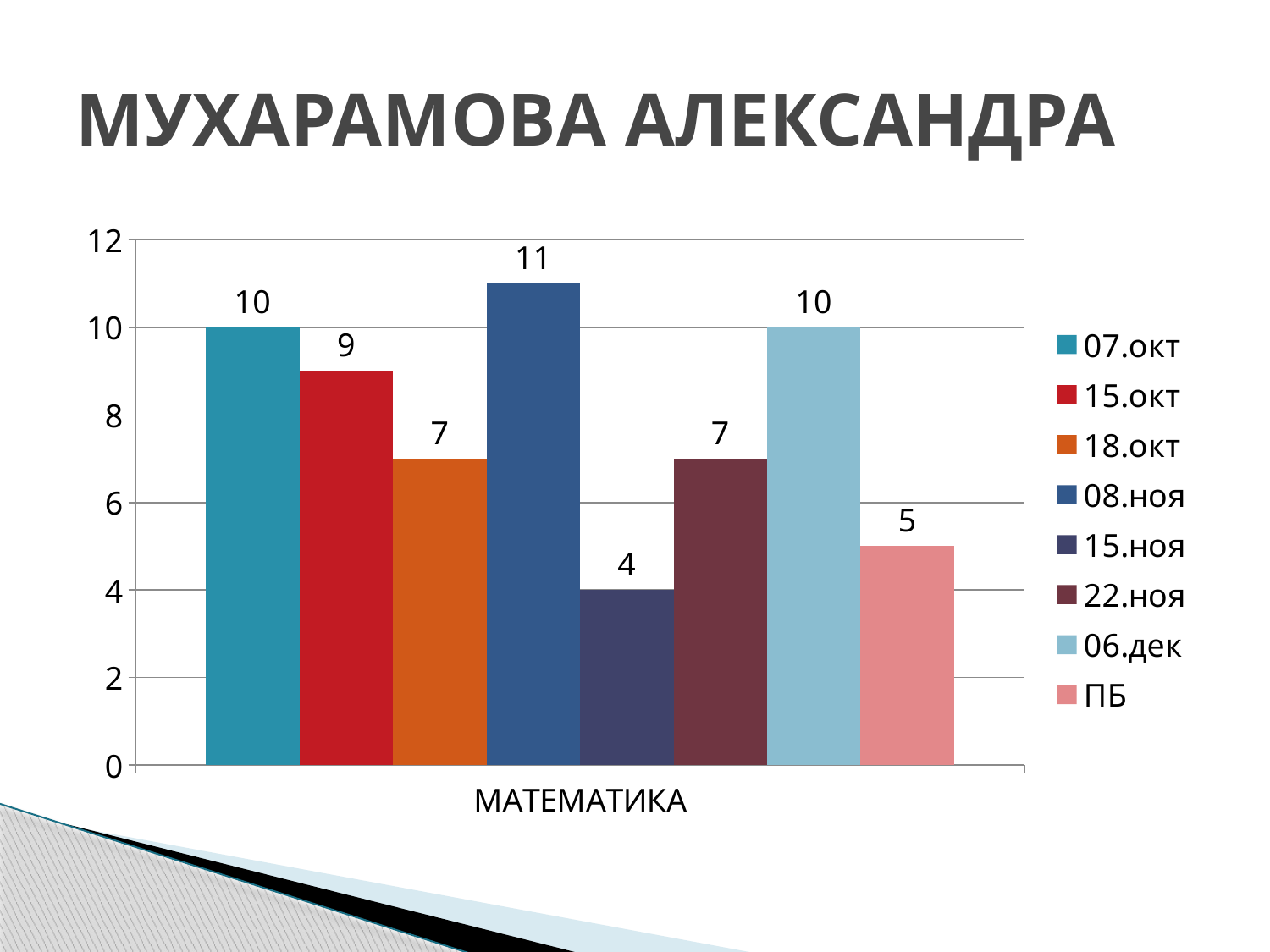
What kind of chart is shown on the slide? Bar chart Which series has the highest value? 08.ноя How many series does the legend list? 8 What is the value for the ПБ series? 5 Which is larger, the value for 15.окт or the value for 22.ноя? 15.окт What is the difference between the values for 08.ноя and 15.ноя? 7 What is the value for the 08.ноя series in the МАТЕМАТИКА category? 11 What is the value for the 15.окт series? 9 What is the difference between the values for 07.окт and ПБ? 5 What is the value for the 15.ноя series? 4 What is the category label shown on the x axis? МАТЕМАТИКА Which series has the lowest value? 15.ноя